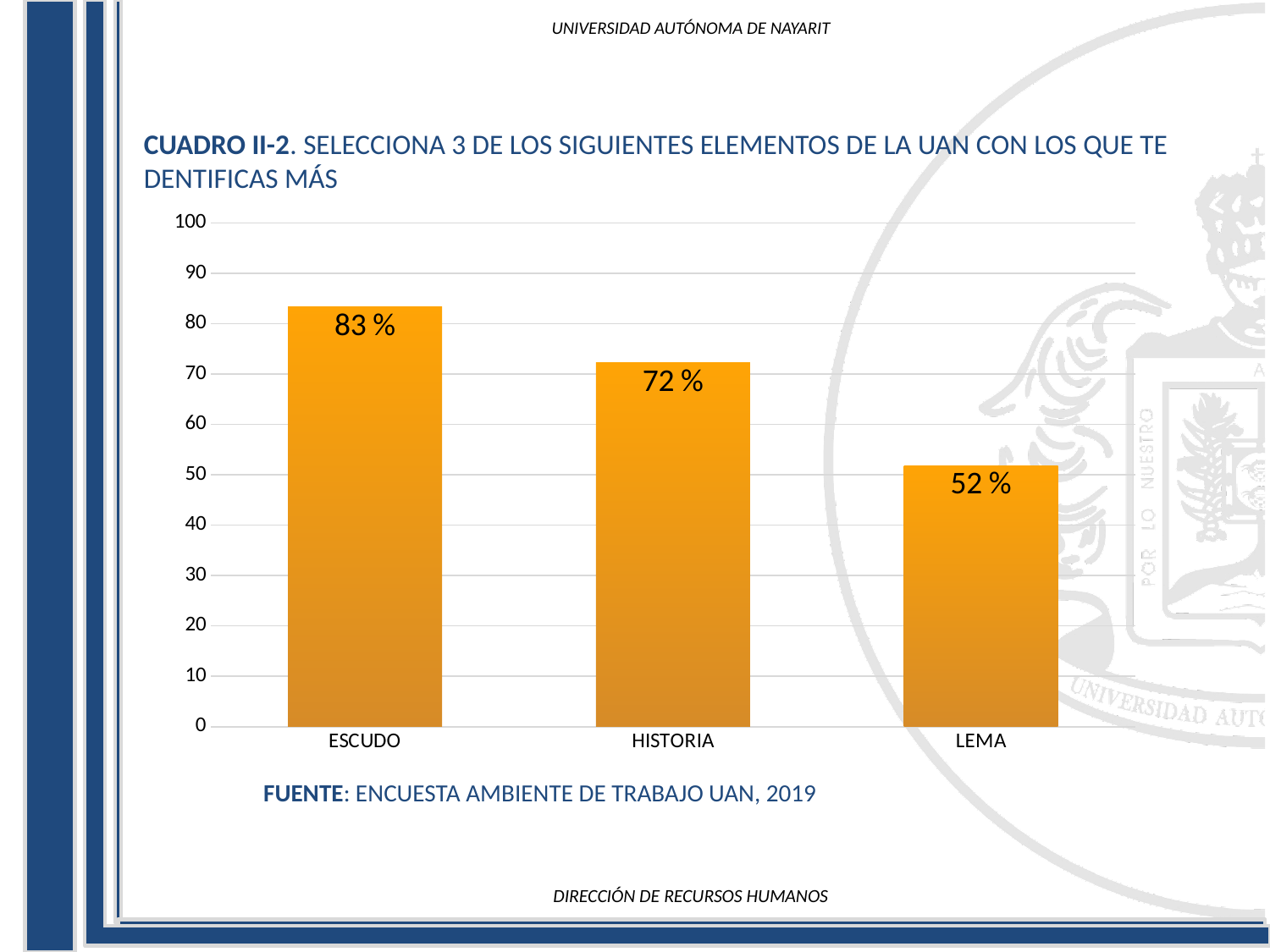
Which category has the lowest value? LEMA What kind of chart is shown on the slide? bar chart What is the value for HISTORIA? 72 % How many categories are shown in the chart? 3 What source is cited below the chart? ENCUESTA AMBIENTE DE TRABAJO UAN, 2019 What is the value for LEMA? 52 % Is the value for LEMA greater or less than 60? less What is the difference between the values for ESCUDO and HISTORIA? 11 % What is the value for ESCUDO? 83 % Which category has the highest value? ESCUDO What is the difference between the values for ESCUDO and LEMA? 31 % Which is larger, the value for HISTORIA or the value for LEMA? HISTORIA